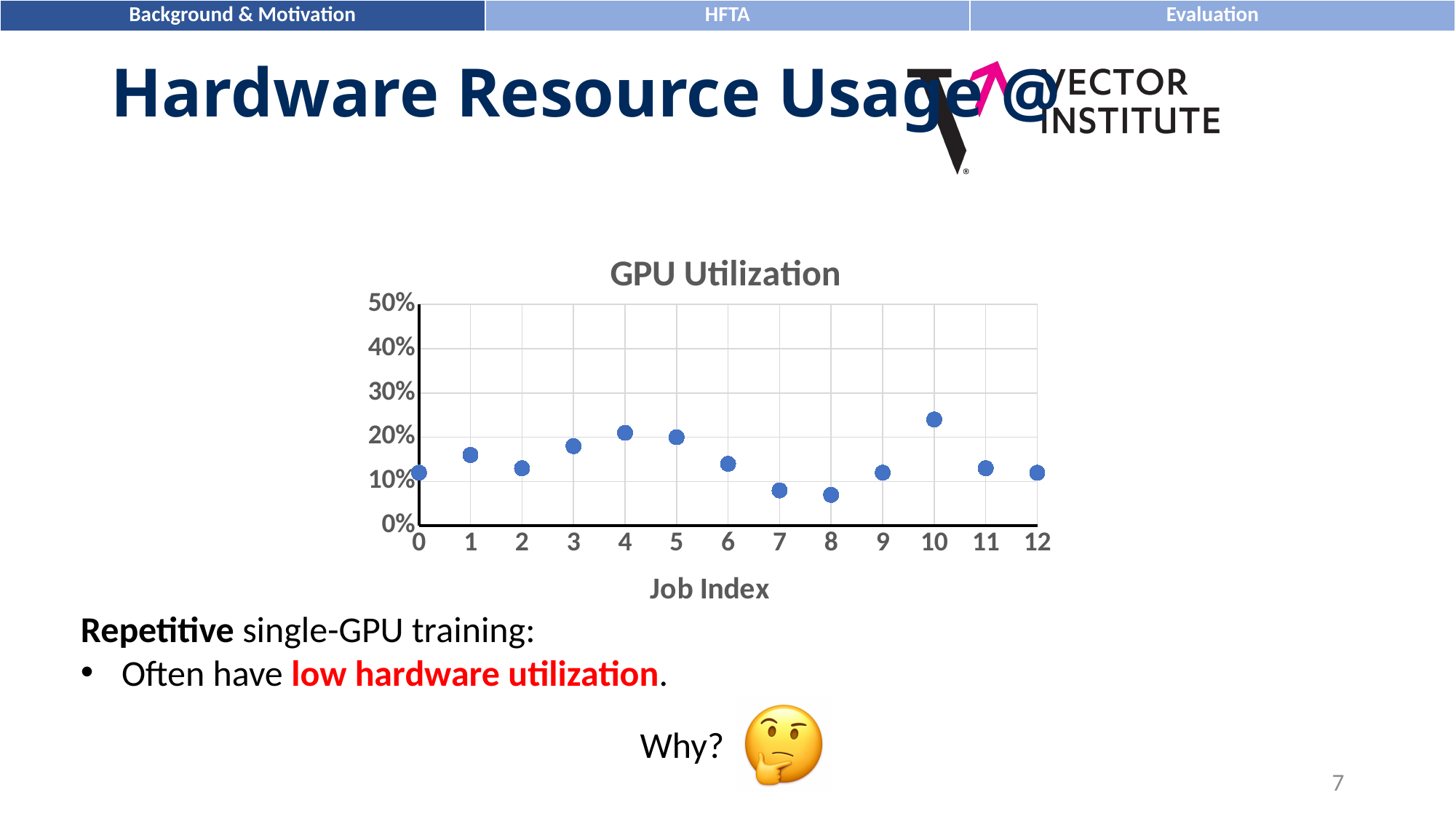
Is the GPU utilization for job index 7 greater or less than 10%? less How many data points are plotted in the GPU Utilization chart? 13 What is the label of the x axis of the chart? Job Index Which has higher GPU utilization, job index 4 or job index 7? job index 4 Is the GPU utilization for job index 3 greater or less than 20%? less What type of chart is shown on the slide? scatter chart What is the title of the chart? GPU Utilization Is the GPU utilization for job index 8 greater or less than 10%? less Which job index has the highest GPU utilization? 10 Which has higher GPU utilization, job index 10 or job index 8? job index 10